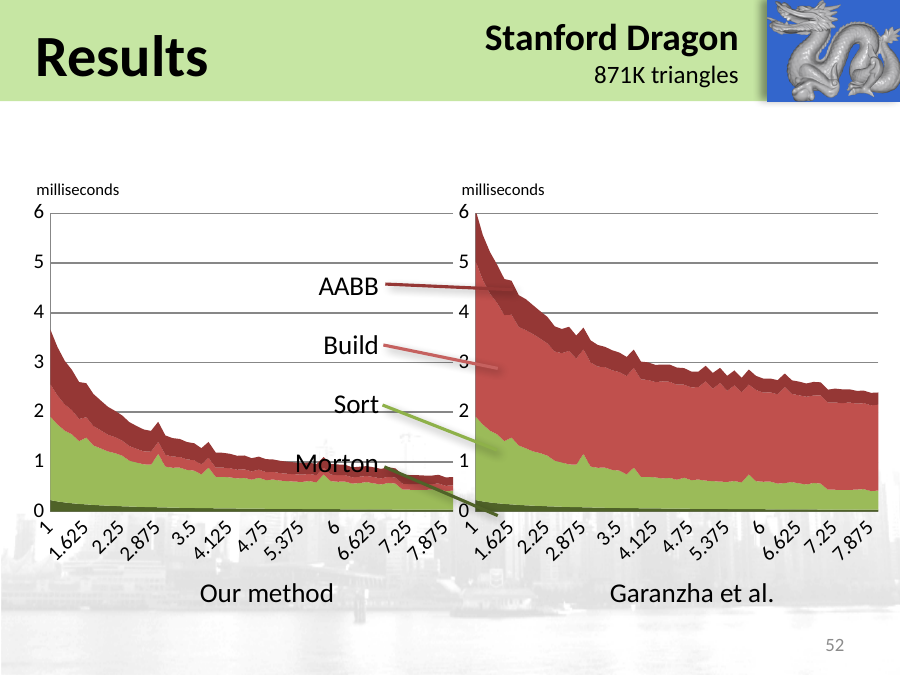
In the 'Garanzha et al.' chart, is the total value at x = 1 greater or less than 5 milliseconds? greater In the 'Our method' chart, is the total value at x = 7.875 greater or less than 1 millisecond? less How many tick labels are shown on the x axis of the 'Our method' chart? 12 How many series are labelled on the slide (AABB, Build, Sort, Morton)? 4 Which chart shows the larger total value at x = 1, 'Our method' or 'Garanzha et al.'? Garanzha et al. What kind of chart is the 'Our method' chart on the left? Stacked area chart In the 'Our method' chart, do the total values rise or fall as you move along the x axis? Fall In the 'Our method' chart, is the total value at x = 1 greater or less than 3 milliseconds? greater In the 'Garanzha et al.' chart, do the total values rise or fall as you move along the x axis? Fall Which series is at the bottom of the stack in both charts? Morton What unit is shown on the y axis of both charts? milliseconds